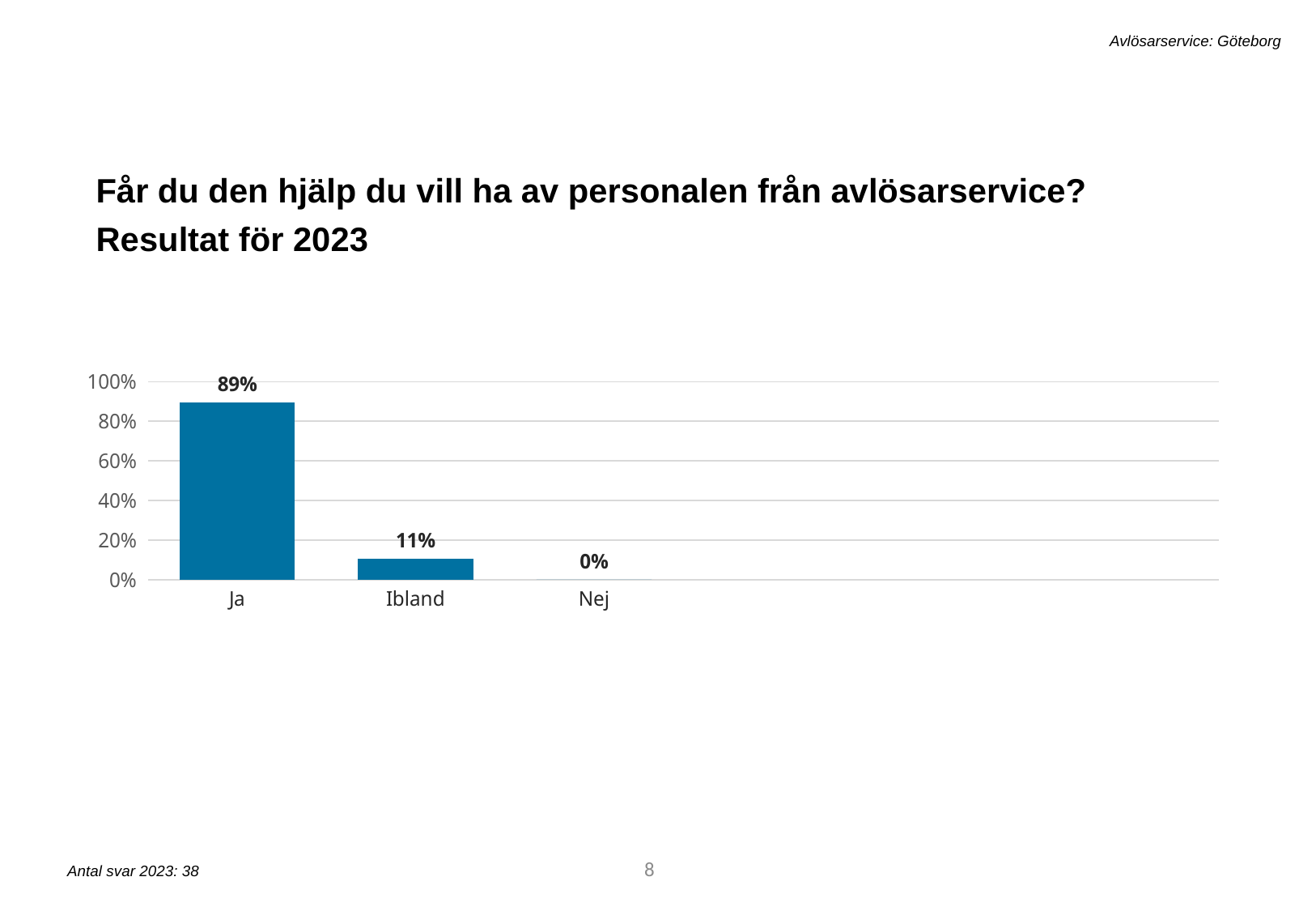
What is the value for Ibland? 11% What is the value for Ja? 89% Which category has the highest value? Ja What kind of chart is shown on the slide? bar chart What is the value for Nej? 0% Is the value for Ibland greater or less than 20%? less How many categories are shown on the x axis? 3 Which category has the lowest value? Nej What is the highest value shown on the y axis? 100% Is the value for Ja greater or less than 80%? greater What is the difference between the values for Ja and Ibland? 78% Which is larger, the value for Ibland or the value for Nej? Ibland